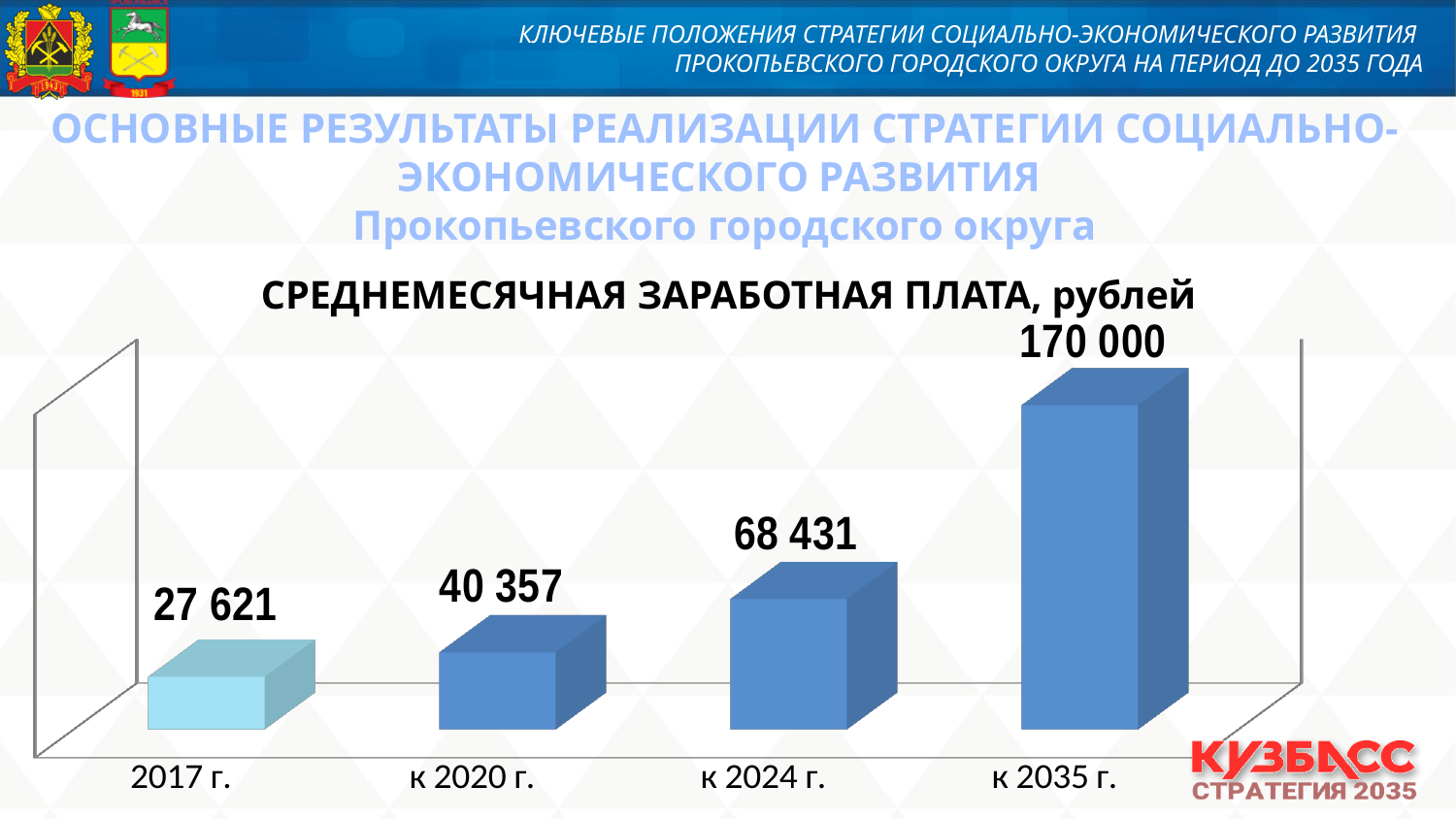
Do the values rise or fall from 2017 г. to к 2035 г.? Rise Which category has the highest value? к 2035 г. What is the value for к 2024 г.? 68 431 What kind of chart is shown on the slide? Bar chart What is the difference between the values for к 2035 г. and к 2024 г.? 101 569 What is the value for к 2020 г.? 40 357 Which is larger, the value for к 2024 г. or the value for к 2020 г.? к 2024 г. What is the value for к 2035 г.? 170 000 Which category has the lowest value? 2017 г. How many categories are shown on the chart? 4 What is the value for 2017 г.? 27 621 What is the difference between the values for к 2020 г. and 2017 г.? 12 736